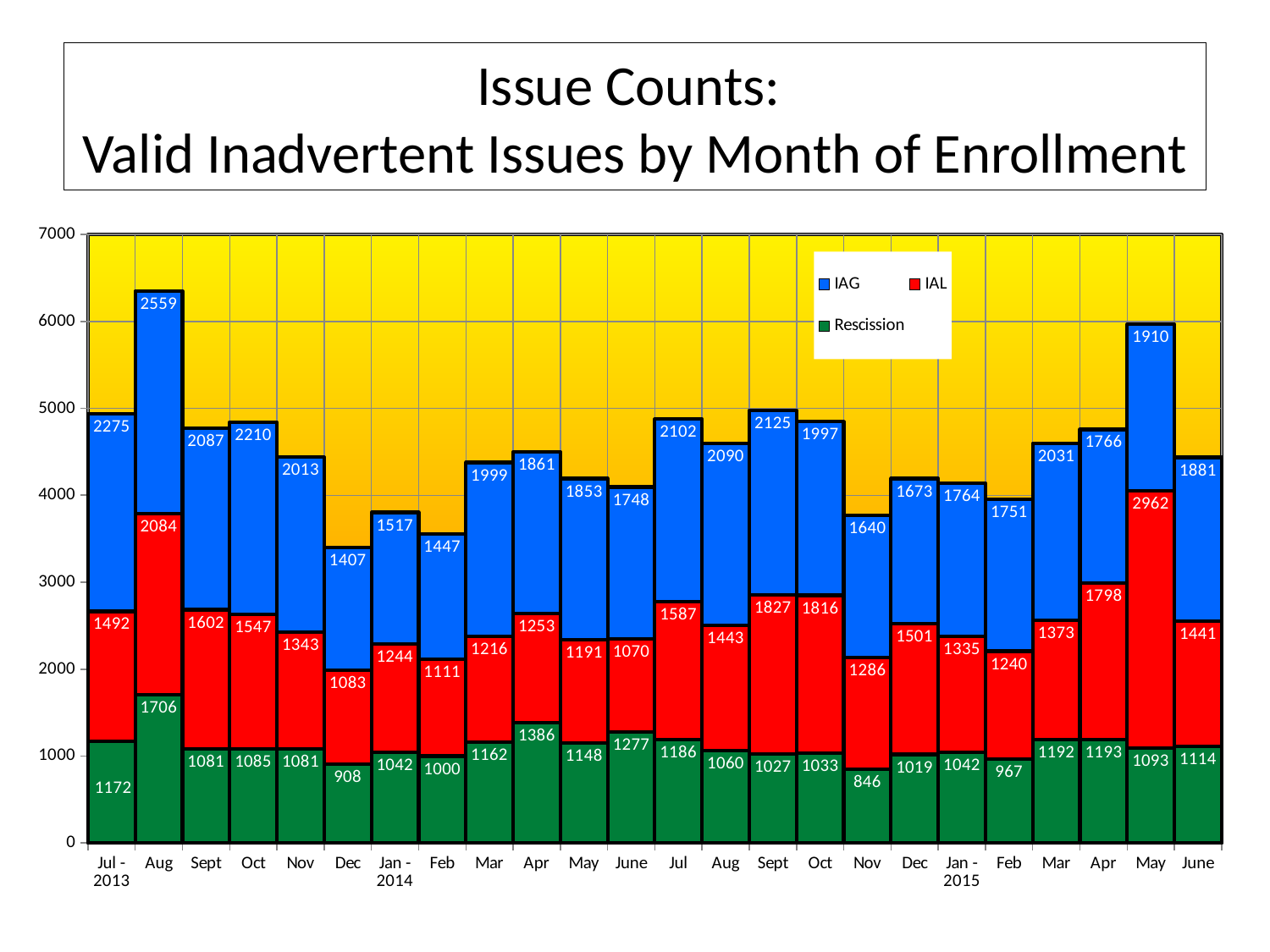
What is the total of the stacked bar for Aug 2013? 6349 What is the Rescission value for Nov 2014? 846 What colour represents the Rescission series? Green Which month has the lowest Rescission value? Nov 2014 What kind of chart is shown on the slide? Stacked bar chart What is the IAG value for Aug 2013? 2559 How many months are shown on the x axis? 24 What is the difference between the IAG value for Aug 2013 and the IAG value for Sept 2013? 472 How many series does the legend list? 3 Which month has the highest IAG value? Aug 2013 For Apr 2015, which is larger: the IAL value or the IAG value? IAL What is the IAL value for May 2015? 2962